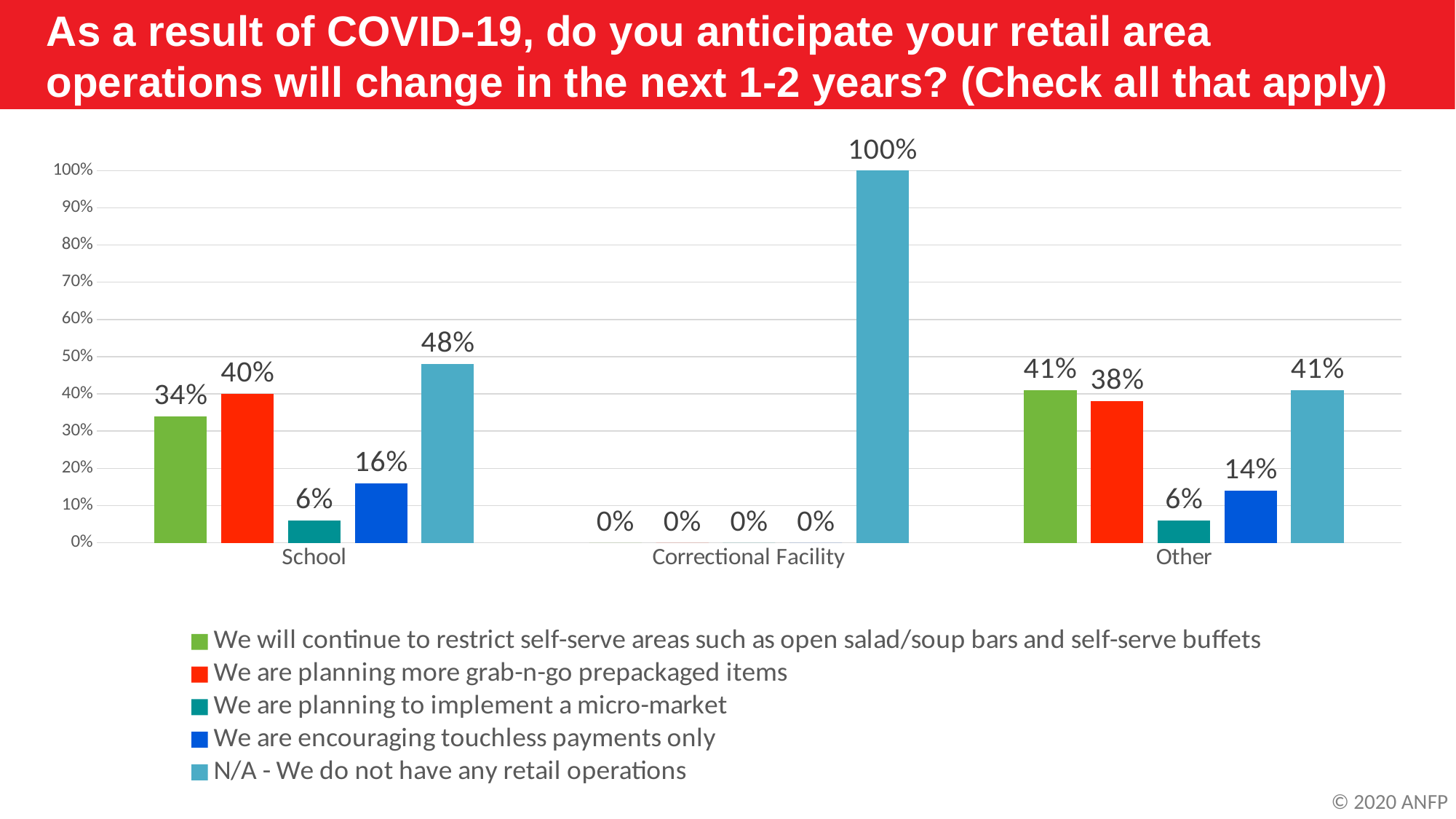
What percentage of School respondents said they are planning more grab-n-go prepackaged items? 40% What is the value for 'N/A - We do not have any retail operations' in the Correctional Facility category? 100% What type of chart is shown on the slide? Bar chart What is the difference between the 'N/A - We do not have any retail operations' value for School and the 'We will continue to restrict self-serve areas' value for School? 14% What is the value for 'We are encouraging touchless payments only' in the School category? 16% What colour represents 'We are planning more grab-n-go prepackaged items' in the legend? Red How many categories are shown on the x axis? 3 Is the 'We are encouraging touchless payments only' value higher for School or for Other? School Which category has the highest value for 'N/A - We do not have any retail operations'? Correctional Facility How many series does the legend list? 5 Which response option has the lowest value in the Other category? We are planning to implement a micro-market What percentage of Other respondents said they will continue to restrict self-serve areas such as open salad/soup bars and self-serve buffets? 41%